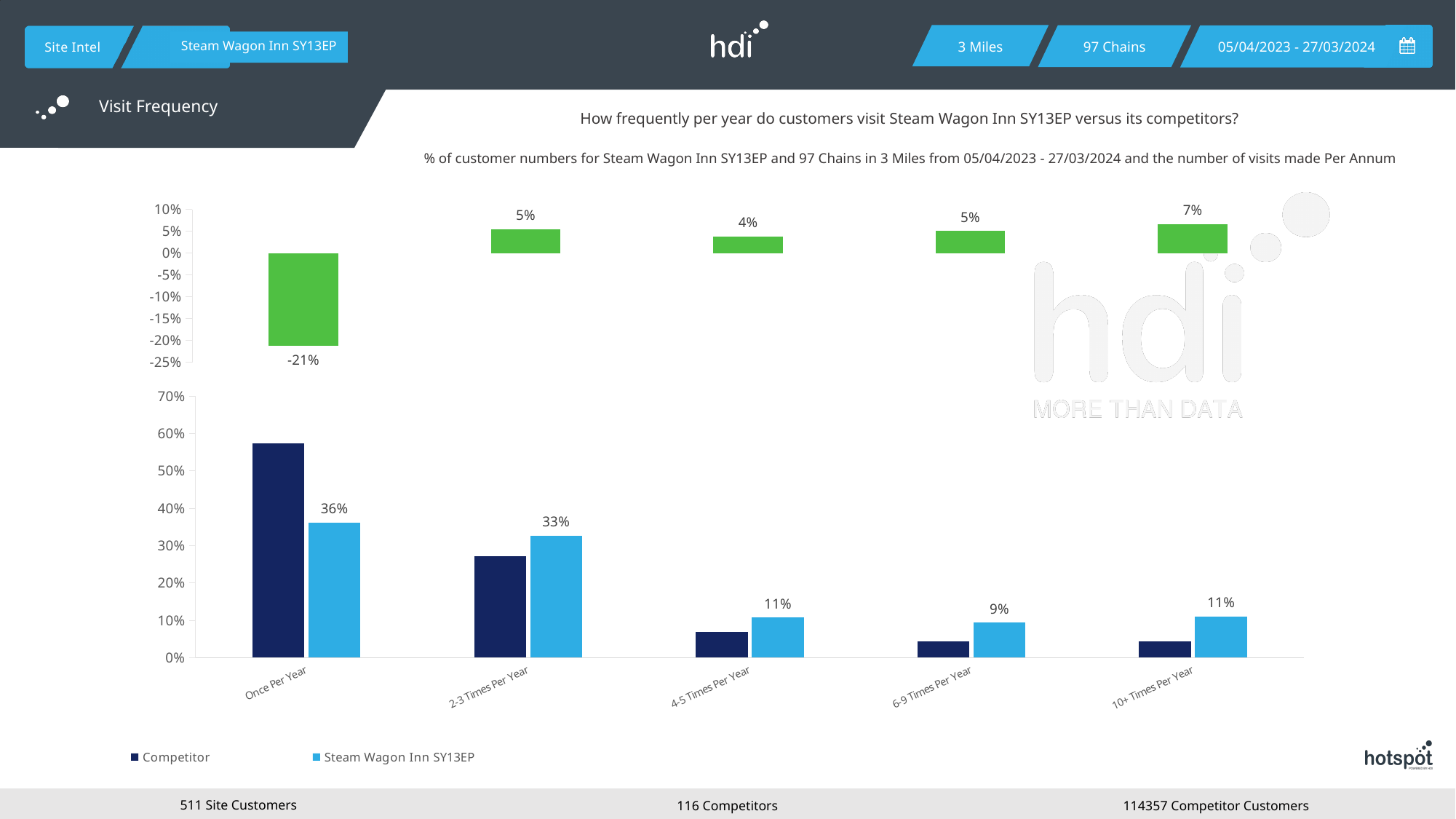
What kind of chart is the bottom chart? Bar chart In the top chart, which category has the lowest value? Once Per Year In the bottom chart, which is larger for 4-5 Times Per Year: Competitor or Steam Wagon Inn SY13EP? Steam Wagon Inn SY13EP In the top chart, which category has the highest value? 10+ Times Per Year In the bottom chart, what is the difference between the Steam Wagon Inn SY13EP values for Once Per Year and 2-3 Times Per Year? 3% How many series does the legend of the bottom chart list? 2 In the bottom chart, is the Competitor value for Once Per Year greater or less than 50%? greater In the bottom chart, what is the value for Steam Wagon Inn SY13EP for 6-9 Times Per Year? 9% In the bottom chart, what is the value for Steam Wagon Inn SY13EP for Once Per Year? 36% In the top chart, what is the value for 10+ Times Per Year? 7% In the top chart, what is the value for Once Per Year? -21% In the bottom chart, what is the value for Steam Wagon Inn SY13EP for 2-3 Times Per Year? 33%